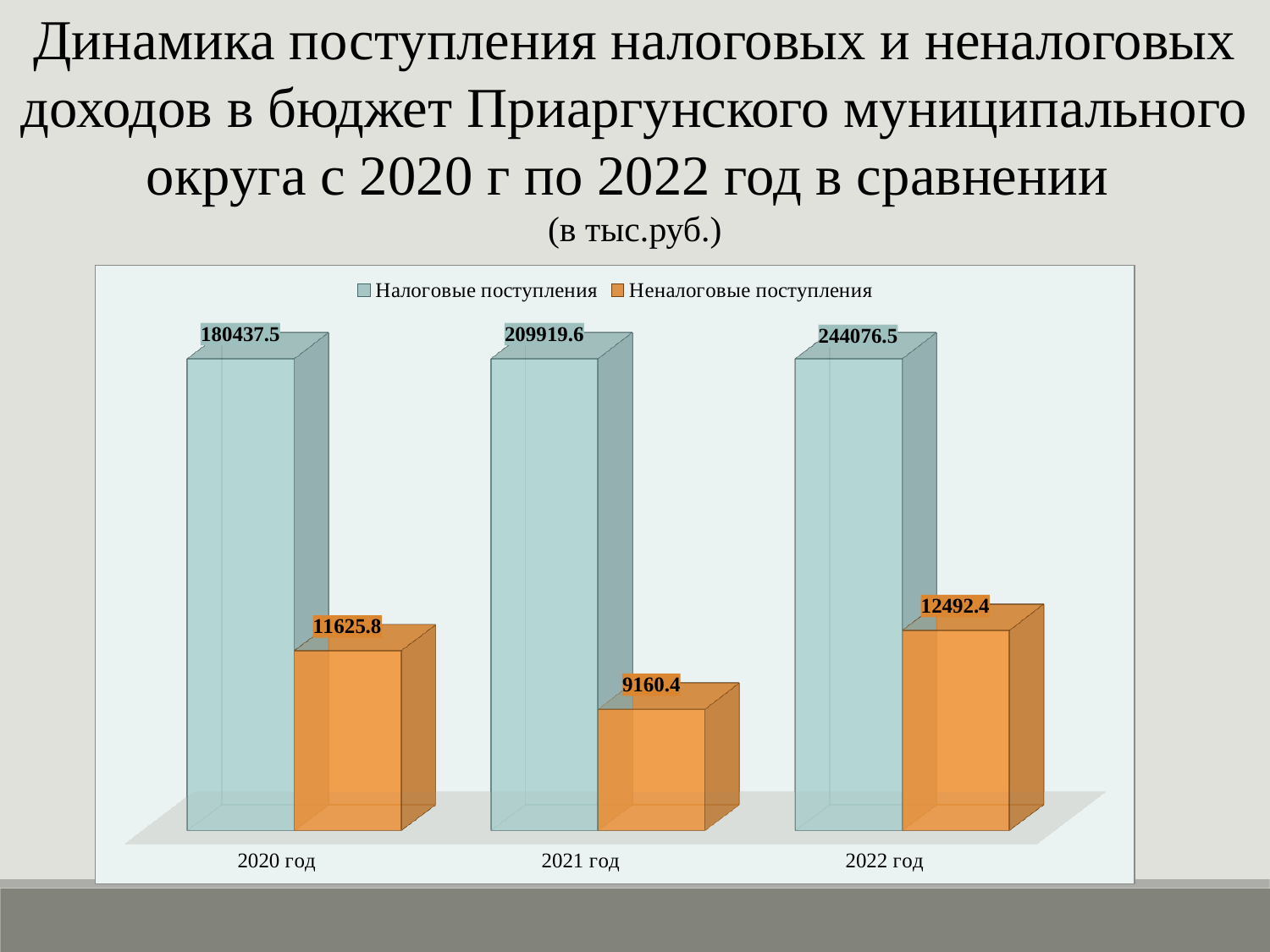
What is the value of Налоговые поступления for 2022 год? 244076.5 In which year are Неналоговые поступления the lowest? 2021 год Which is larger: Неналоговые поступления in 2020 год or in 2021 год? 2020 год Do Налоговые поступления rise or fall from 2020 год to 2022 год? rise How many series does the legend list? 2 What is the value of Неналоговые поступления for 2022 год? 12492.4 What is the difference between Неналоговые поступления in 2022 год and 2021 год? 3332.0 What is the value of Неналоговые поступления for 2021 год? 9160.4 How many years are shown on the x axis? 3 What is the value of Налоговые поступления for 2020 год? 180437.5 In which year are Налоговые поступления the highest? 2022 год What is the difference between Налоговые поступления in 2022 год and 2020 год? 63639.0